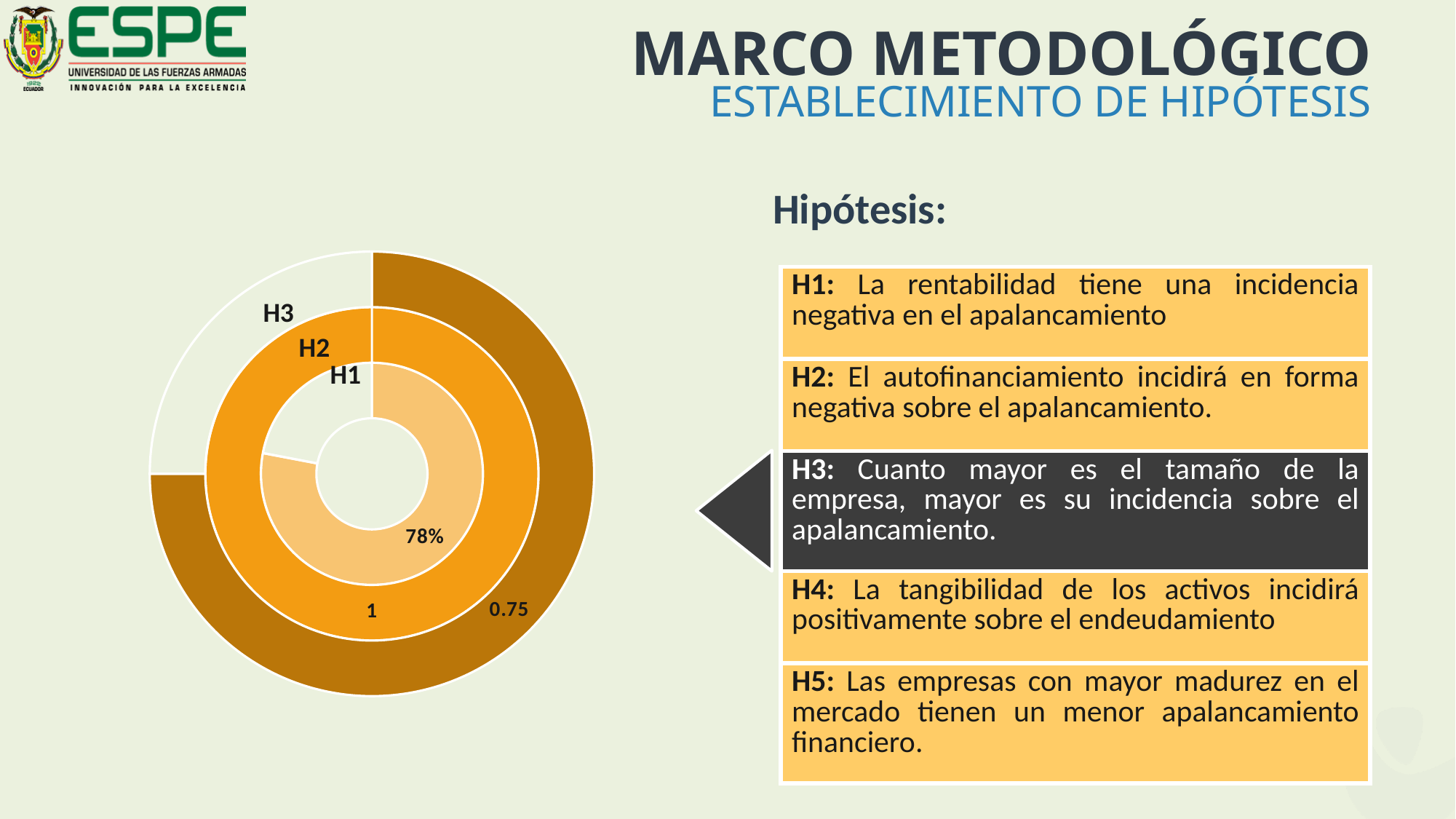
Which hypothesis label is on the outermost ring of the doughnut chart? H3 What value is labelled on the H3 ring of the doughnut chart? 0.75 What kind of chart is shown on the left of the slide? Doughnut chart What value is labelled on the H2 ring of the doughnut chart? 1 Which ring of the doughnut chart has the highest value? H2 What value is labelled on the H1 ring of the doughnut chart? 78% Which hypothesis label is on the innermost ring of the doughnut chart? H1 Which has the larger value in the doughnut chart, H2 or H3? H2 How many rings (series) does the doughnut chart show? 3